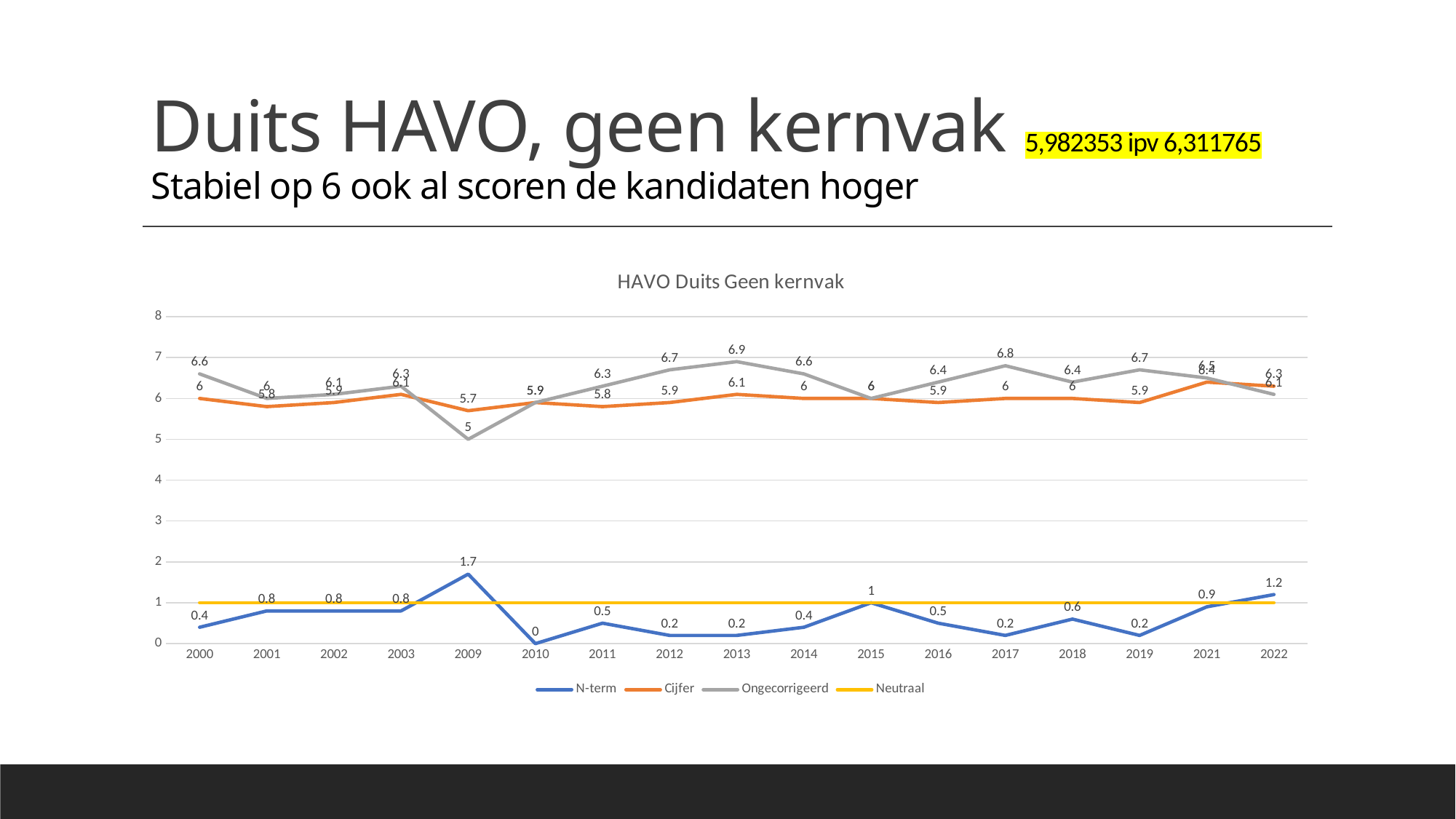
What kind of chart is shown? line chart In which year is the Ongecorrigeerd value lowest? 2009 What is the difference between the Cijfer and Ongecorrigeerd values in 2009? 0.7 What is the Ongecorrigeerd value for 2013? 6.9 What is the N-term value for 2009? 1.7 How many years are shown on the x axis? 17 In 2013, which is larger: Cijfer or Ongecorrigeerd? Ongecorrigeerd How many series does the legend list? 4 What is the difference between the N-term values for 2009 and 2010? 1.7 In which year is the N-term highest? 2009 In which year is the N-term lowest? 2010 What is the Cijfer value for 2000? 6